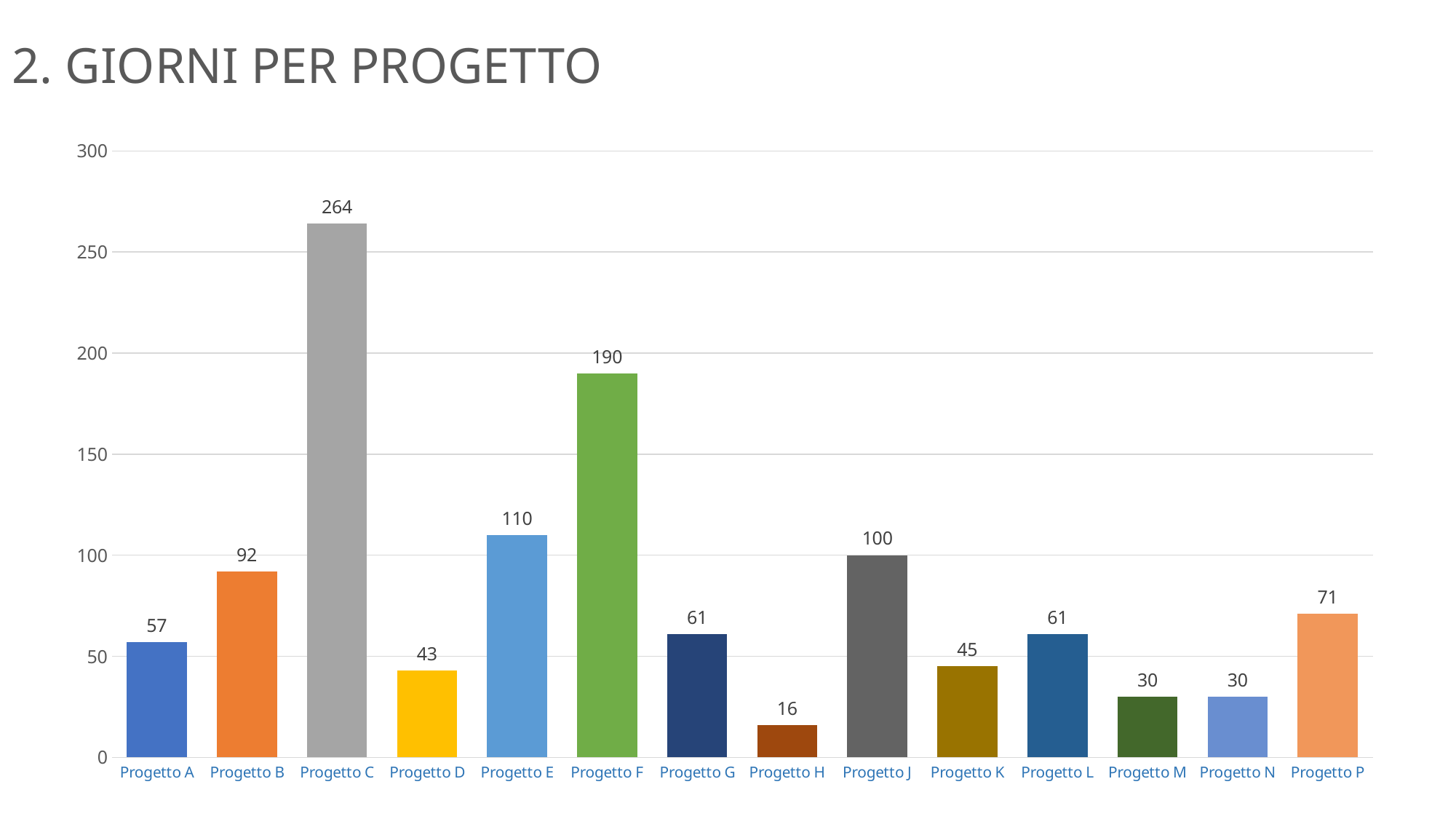
What is the difference between the values for Progetto E and Progetto J? 10 What is the title of the slide? 2. GIORNI PER PROGETTO How many projects are shown on the chart? 14 Which project has the lowest value? Progetto H Is the value for Progetto F greater or less than 150? greater What is the difference between the values for Progetto C and Progetto F? 74 Which is larger, the value for Progetto B or the value for Progetto P? Progetto B What is the value for Progetto C? 264 What is the value for Progetto P? 71 Which project has the highest value? Progetto C What kind of chart is shown on the slide? Bar chart What is the value for Progetto H? 16